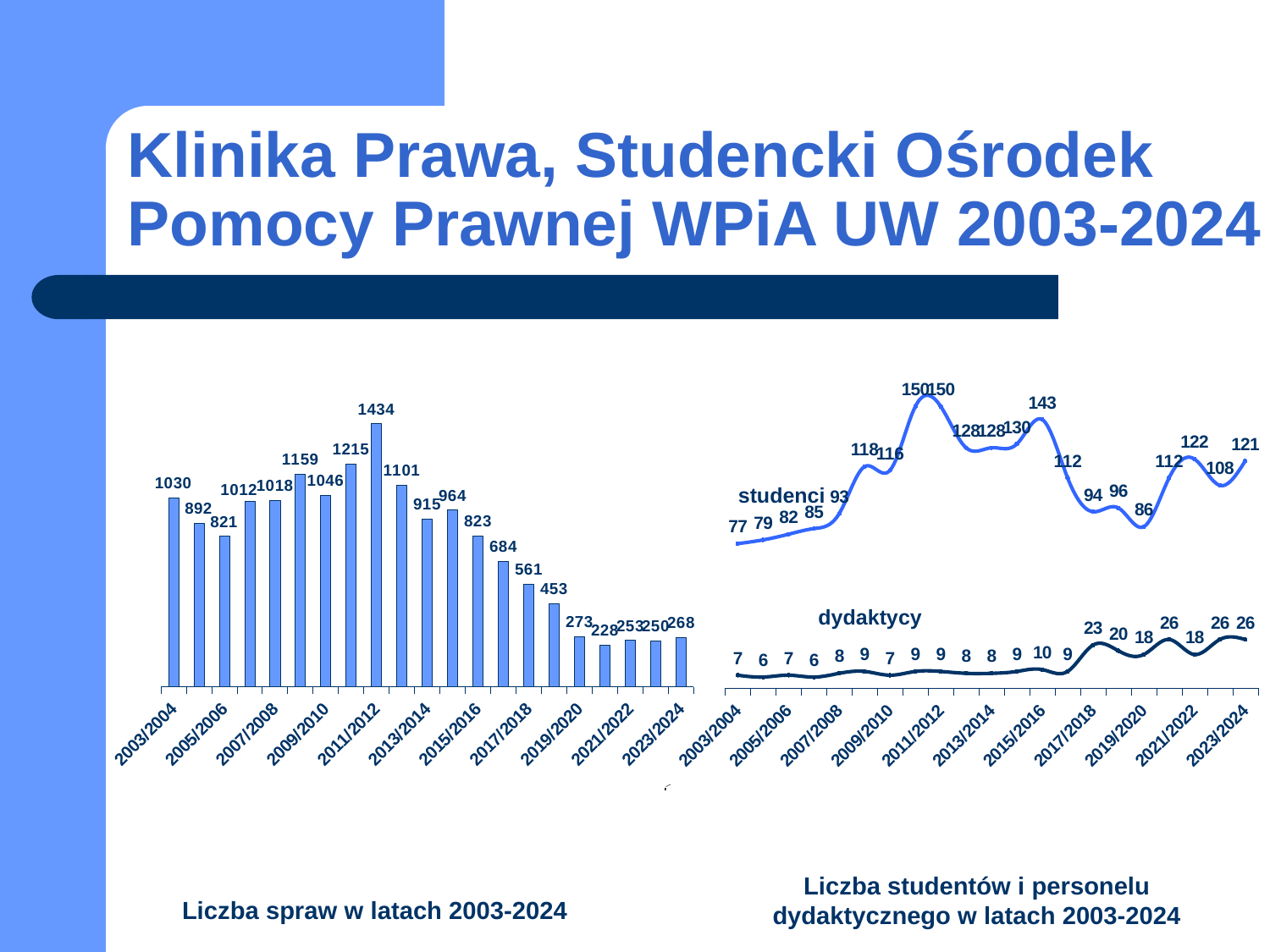
In the left chart 'Liczba spraw w latach 2003-2024', what is the value for 2023/2024? 268 What kind of chart is the right chart, 'Liczba studentów i personelu dydaktycznego w latach 2003-2024'? line chart In the left chart 'Liczba spraw w latach 2003-2024', which academic year has the highest number of cases? 2011/2012 In the left chart 'Liczba spraw w latach 2003-2024', what is the lowest value shown? 228 In the right chart, what is the difference between the 'dydaktycy' value for 2023/2024 (26) and for 2003/2004 (7)? 19 In the left chart 'Liczba spraw w latach 2003-2024', what is the difference between the highest value (1434) and the value for 2003/2004 (1030)? 404 How many bars are plotted in the left chart 'Liczba spraw w latach 2003-2024'? 21 In the left chart 'Liczba spraw w latach 2003-2024', what is the value for 2003/2004? 1030 How many series are shown in the right chart 'Liczba studentów i personelu dydaktycznego w latach 2003-2024'? 2 In the right chart, what is the value of 'studenci' for 2003/2004? 77 What kind of chart is the left chart, 'Liczba spraw w latach 2003-2024'? bar chart In the right chart, what is the highest value of the 'studenci' series? 150